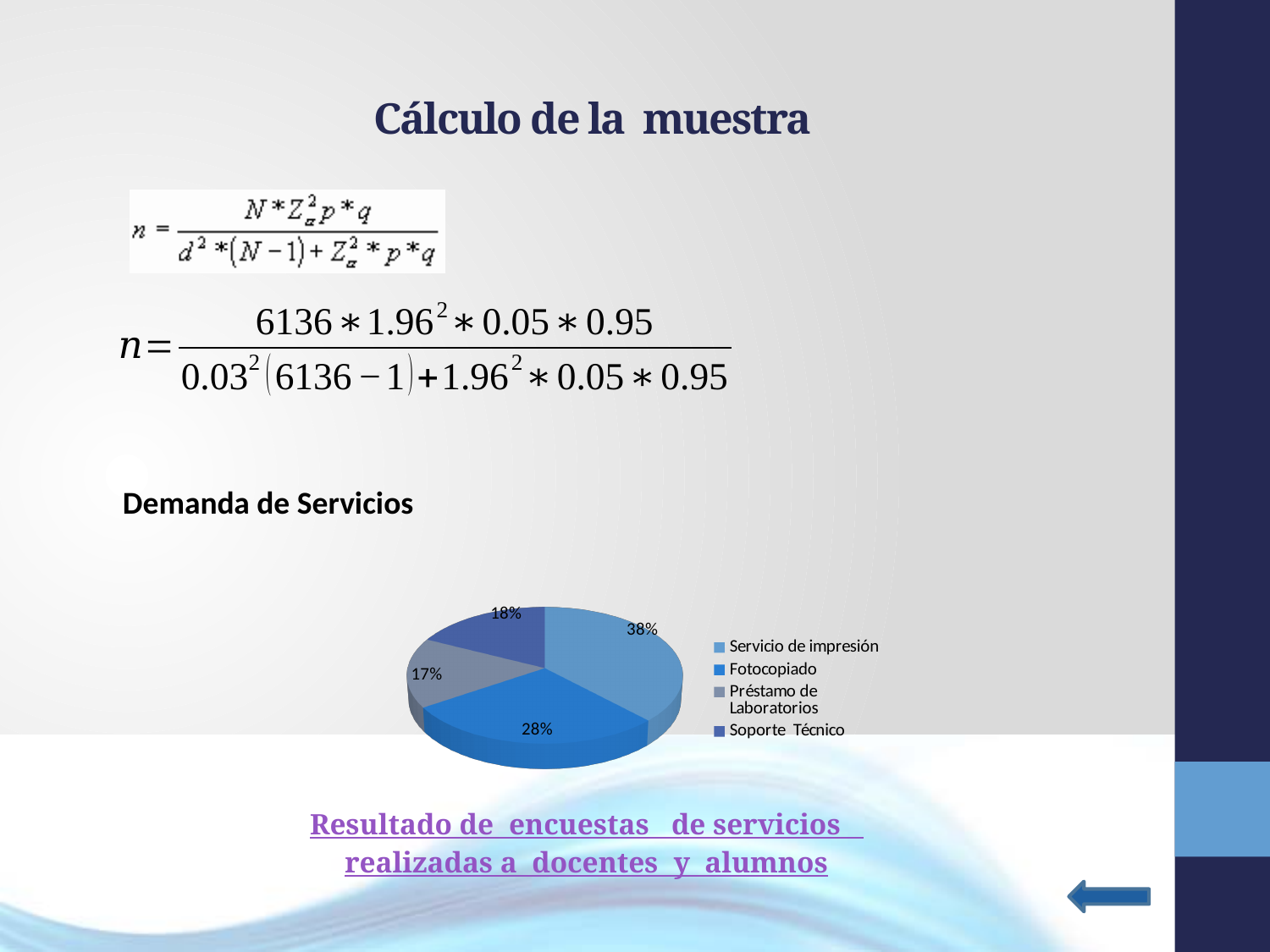
What percentage is shown for Soporte Técnico? 18% Which is larger, the share for Soporte Técnico or the share for Préstamo de Laboratorios? Soporte Técnico What percentage is shown for Fotocopiado? 28% What type of chart is shown on the slide? Pie chart What is the title shown above the pie chart? Demanda de Servicios Which legend entry is listed second in the pie chart's legend? Fotocopiado How many slices does the pie chart have? 4 What is the difference in percentage points between Servicio de impresión and Fotocopiado? 10 What percentage is shown for Préstamo de Laboratorios? 17% Which service has the smallest slice of the pie? Préstamo de Laboratorios Which service has the largest slice of the pie? Servicio de impresión What share of the pie does Servicio de impresión represent? 38%